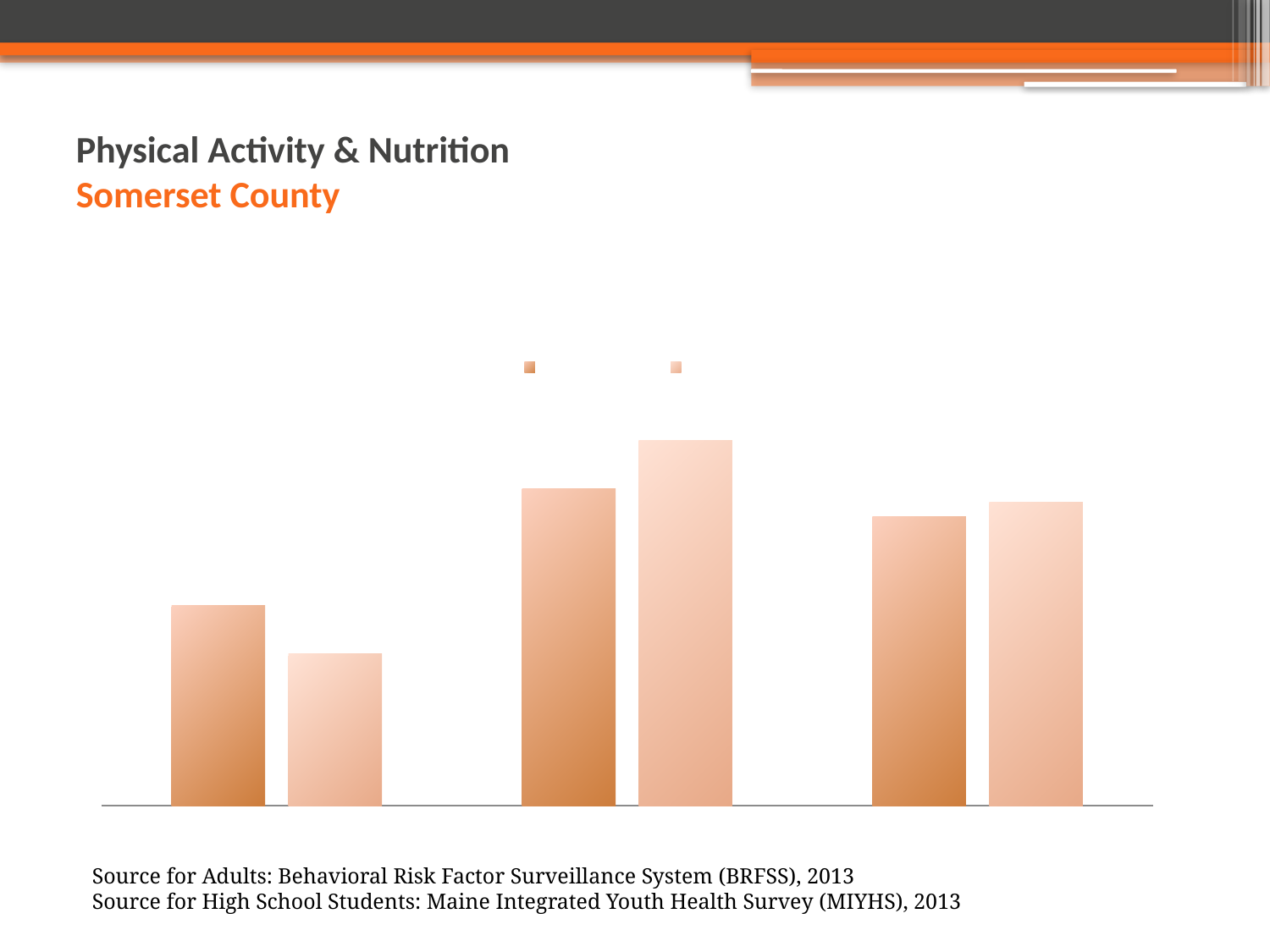
What is the subtitle shown in orange under the slide title? Somerset County In the leftmost group of bars, is the darker orange bar or the lighter orange bar taller? the darker orange bar How many series does the chart's legend list? 2 What kind of chart is shown on the slide? bar chart In the middle group of bars, is the darker orange bar or the lighter orange bar taller? the lighter orange bar What is the title of the slide? Physical Activity & Nutrition Which group of bars (left, middle or right) contains the shortest bar in the chart? left How many bars are plotted in total in the chart? 6 Which group of bars (left, middle or right) contains the tallest bar in the chart? middle How many groups of bars are plotted in the chart? 3